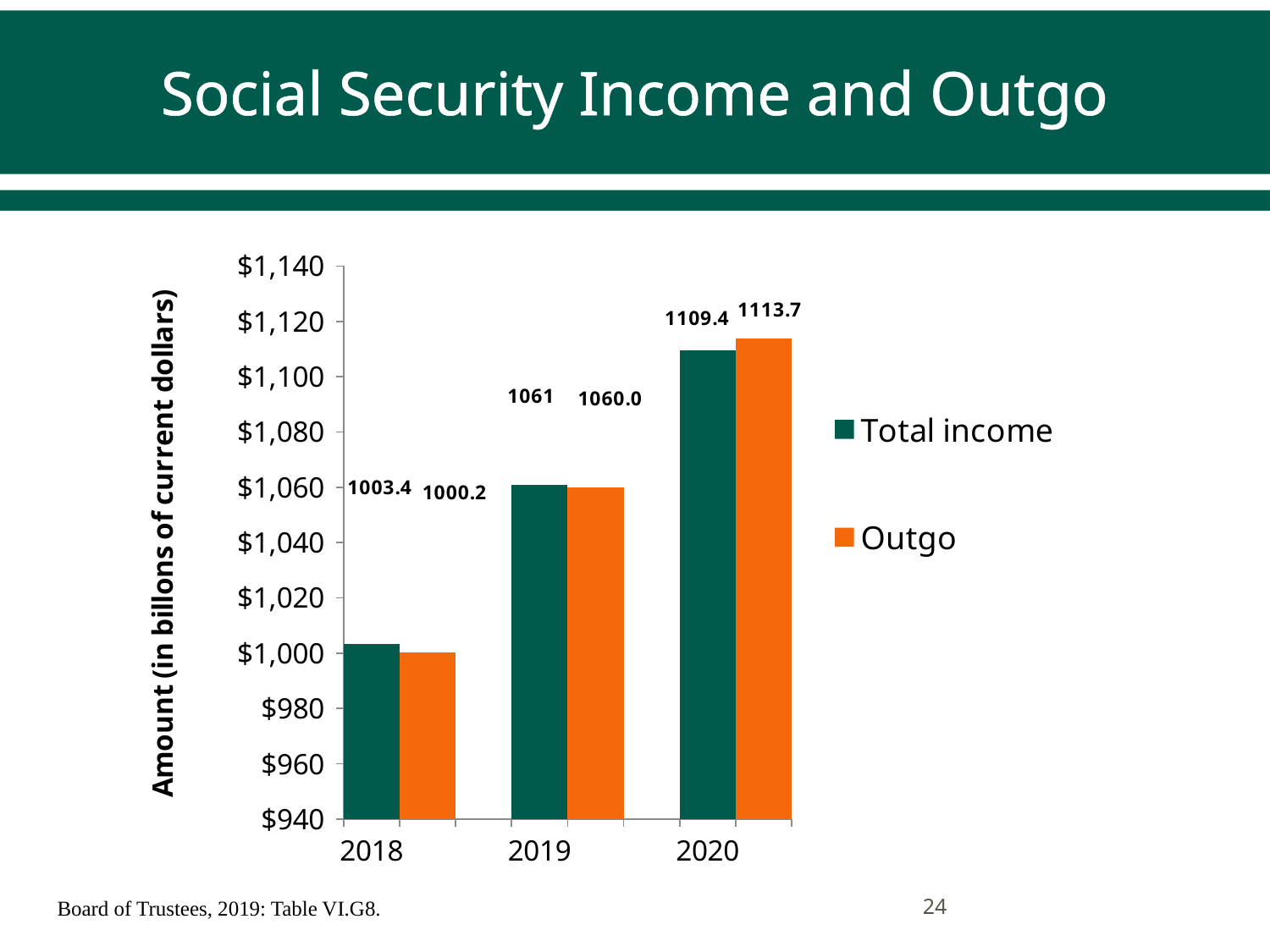
What is the Outgo value for 2020? 1113.7 What kind of chart is shown on the slide? Bar chart What is the Total income value for 2018? 1003.4 Which year has the lowest Total income value? 2018 What is the difference between Total income and Outgo in 2018? 3.2 What is the Total income value for 2020? 1109.4 How many series does the legend list? 2 What is the difference between Outgo and Total income in 2020? 4.3 Which year has the highest Outgo value? 2020 How many years are shown on the x axis? 3 What is the Outgo value for 2019? 1060.0 Which is larger in 2020, Total income or Outgo? Outgo